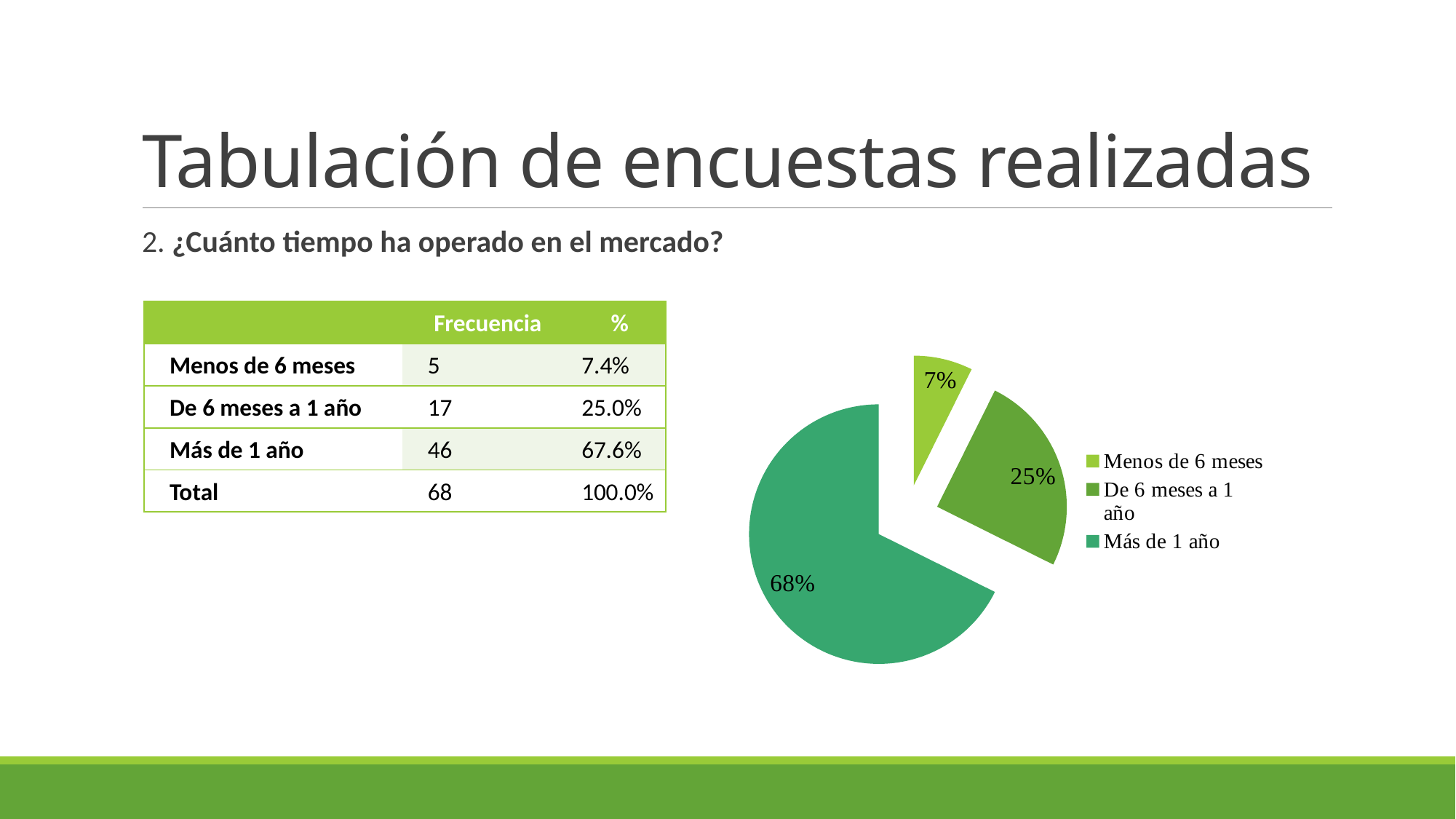
What share of the pie does "Más de 1 año" represent? 68% What is the difference in percentage points between the "Más de 1 año" slice and the "De 6 meses a 1 año" slice? 43% Which slice is larger, "De 6 meses a 1 año" or "Menos de 6 meses"? De 6 meses a 1 año Which category has the largest slice of the pie? Más de 1 año Which legend entry is shown in the lightest green colour? Menos de 6 meses What share of the pie does "De 6 meses a 1 año" represent? 25% What share of the pie does "Menos de 6 meses" represent? 7% How many entries does the legend list? 3 Which category has the smallest slice of the pie? Menos de 6 meses What kind of chart is shown on the slide? pie chart How many slices does the pie chart have? 3